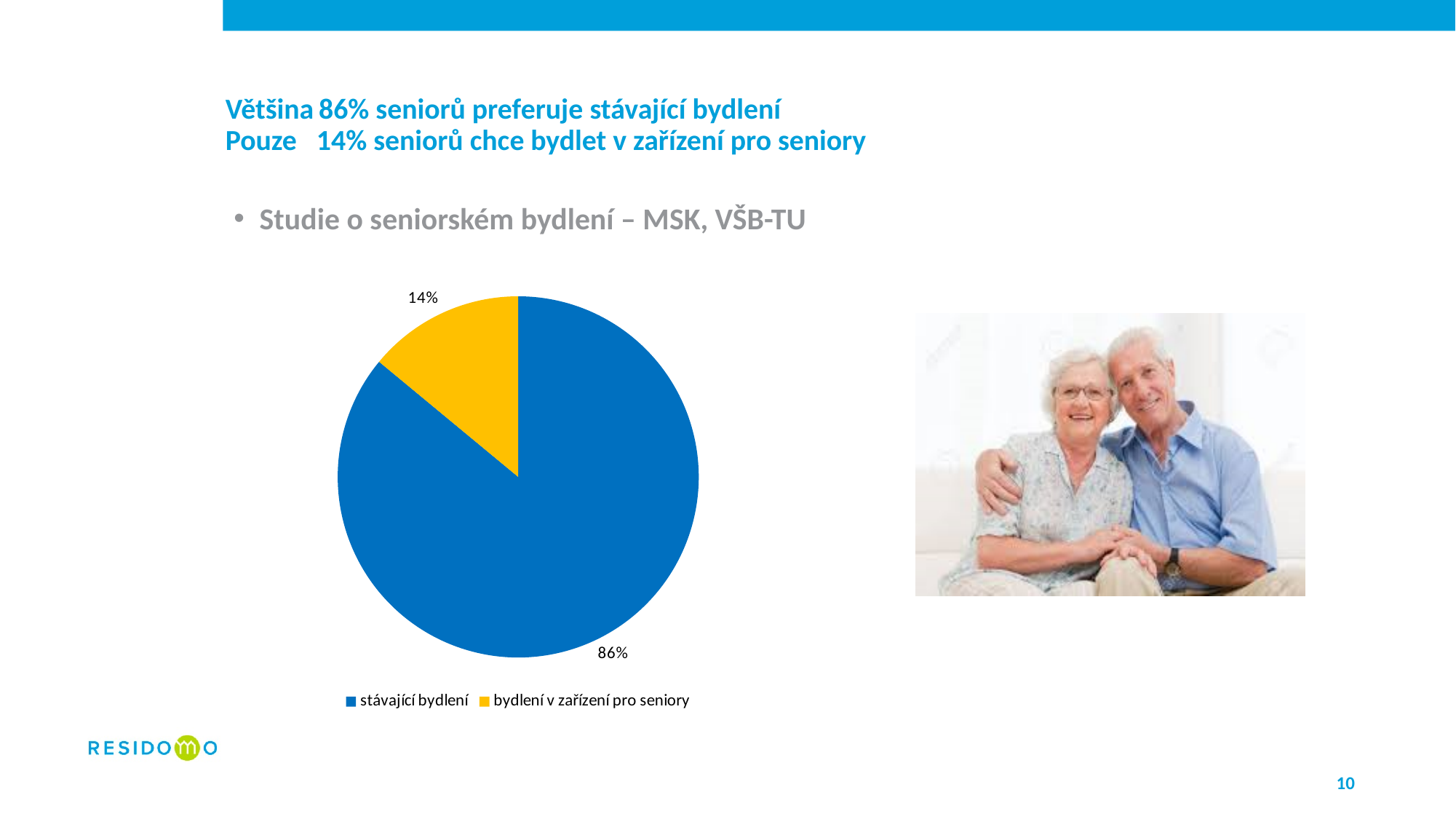
How many entries does the legend of the pie chart list? 2 Which slice of the pie chart is the smallest? bydlení v zařízení pro seniory What colour is the "bydlení v zařízení pro seniory" slice in the pie chart? yellow What colour is the "stávající bydlení" slice in the pie chart? blue Which slice of the pie chart is the largest? stávající bydlení What share of the pie does "bydlení v zařízení pro seniory" represent? 14% Which is larger: the share for "stávající bydlení" or for "bydlení v zařízení pro seniory"? stávající bydlení What is the difference in percentage points between the "stávající bydlení" slice and the "bydlení v zařízení pro seniory" slice? 72 How many slices does the pie chart have? 2 What share of the pie does "stávající bydlení" represent? 86% What kind of chart is shown on the slide? pie chart